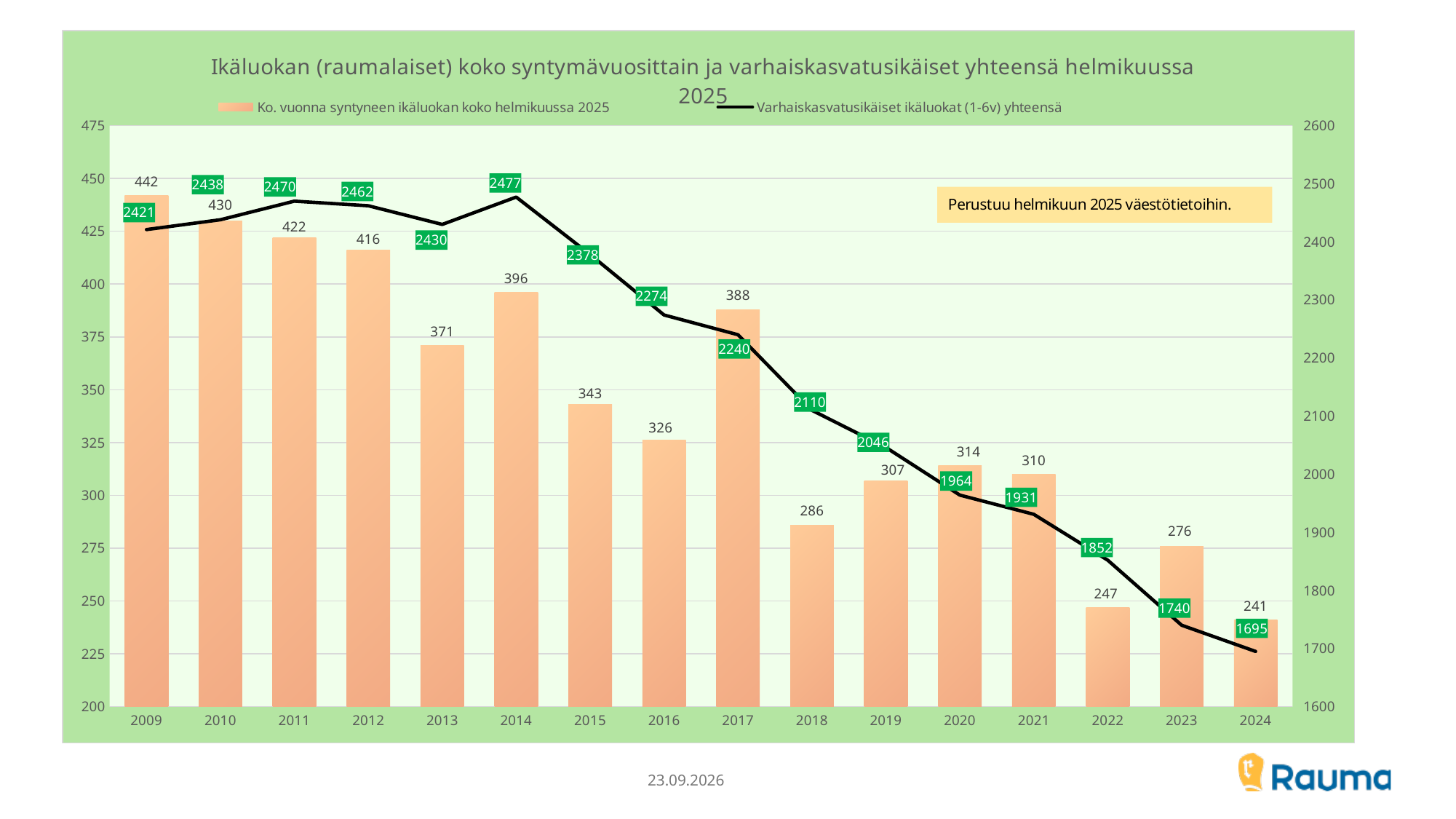
What is the difference between the bar values for 2009 and 2024? 201 Does the line series generally rise or fall from 2014 to 2024? Fall What kind of chart is shown on the slide? Combined bar and line chart What is the value of the bar for 2014? 396 How many series does the legend list? 2 Which year has the highest bar value? 2009 Which is larger, the bar value for 2017 or the bar value for 2013? 2017 What value does the line series (Varhaiskasvatusikäiset ikäluokat (1-6v) yhteensä) show for 2018? 2110 How many years are shown on the x axis? 16 In which year does the line series reach its highest value? 2014 Which year has the lowest value on the line series? 2024 What does the yellow note box on the chart say? Perustuu helmikuun 2025 väestötietoihin.